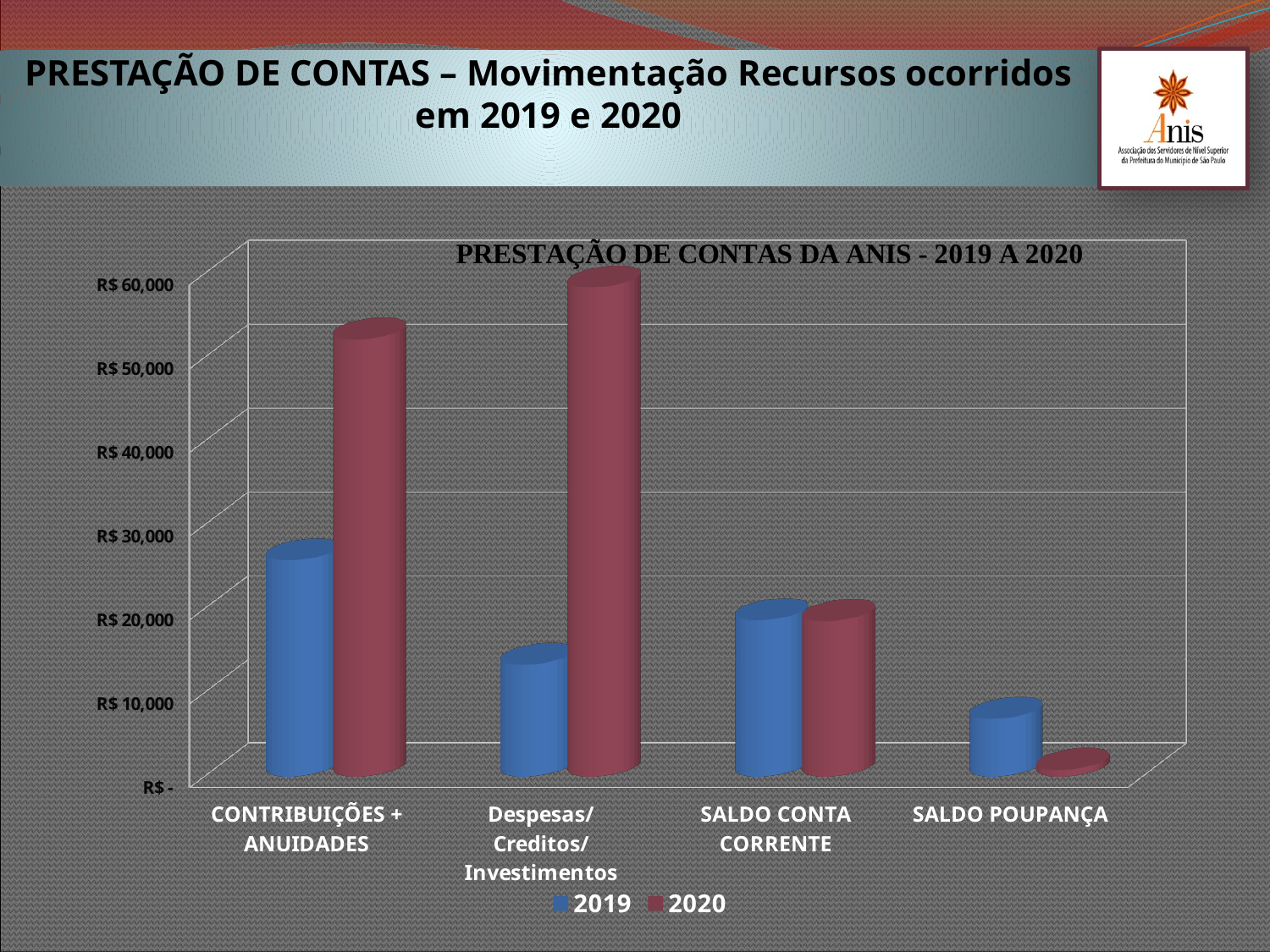
Is the 2020 value for Despesas/Creditos/Investimentos greater or less than R$ 50,000? greater Which category has the lowest value for the 2019 series? SALDO POUPANÇA Which category has the highest value for the 2019 series? CONTRIBUIÇÕES + ANUIDADES Which category has the highest value for the 2020 series? Despesas/Creditos/Investimentos How many series does the legend list? 2 What is the title of the chart? PRESTAÇÃO DE CONTAS DA ANIS - 2019 A 2020 Is the 2019 value for CONTRIBUIÇÕES + ANUIDADES greater or less than R$ 20,000? greater What kind of chart is shown on the slide? Bar chart Is the 2019 value for SALDO POUPANÇA greater or less than R$ 10,000? less Which category has the lowest value for the 2020 series? SALDO POUPANÇA For CONTRIBUIÇÕES + ANUIDADES, which series has the larger value, 2019 or 2020? 2020 How many categories are shown on the x axis? 4